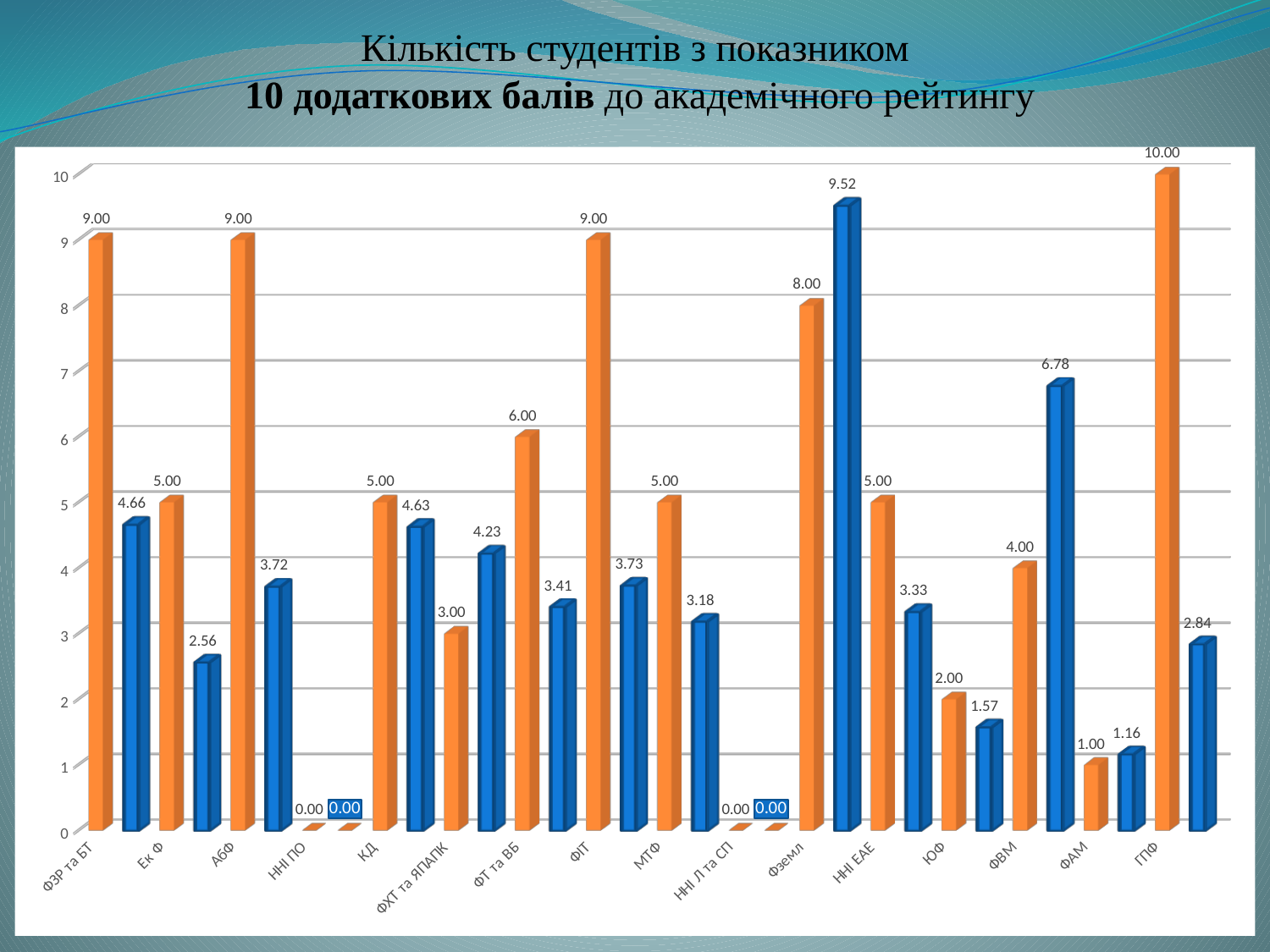
What is the difference between the orange and blue bars for ФЗР та БТ? 4.34 Which is larger, the blue bar for КД or the blue bar for ЮФ? the blue bar for КД How many categories are shown on the x axis? 16 What is the difference between the blue bars for ФЗемл and ФВМ? 2.74 What is the value of the blue bar for ФЗемл? 9.52 Which is larger for ФВМ, the orange bar or the blue bar? the blue bar What is the value of the blue bar for ФВМ? 6.78 What is the value of the orange bar for ГПФ? 10.00 What kind of chart is shown on the slide? bar chart Which category has the highest orange bar? ГПФ Which category has the highest blue bar? ФЗемл What is the value of the orange bar for ФТ та ВБ? 6.00